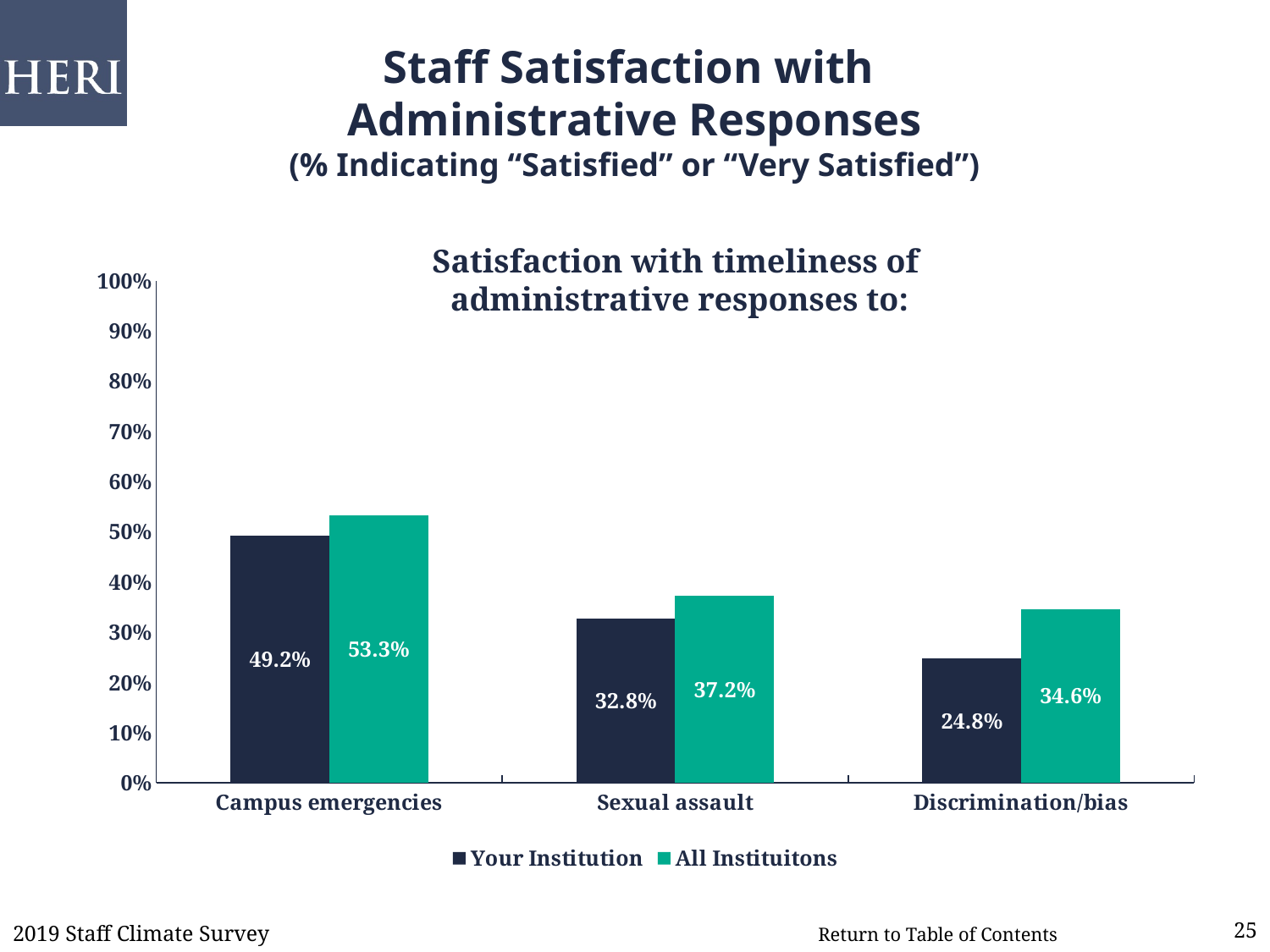
Is the value for Your Institution for Campus emergencies greater or less than 40%? greater Which is larger for Sexual assault: Your Institution or All Instituitons? All Instituitons Which category has the highest value for All Instituitons? Campus emergencies Which category has the lowest value for Your Institution? Discrimination/bias What is the value for Your Institution for Campus emergencies? 49.2% How many series does the legend list? 2 What is the title of the chart? Satisfaction with timeliness of administrative responses to: How many categories are shown on the x axis? 3 What kind of chart is shown on the slide? bar chart What is the value for Your Institution for Sexual assault? 32.8% What is the value for All Instituitons for Discrimination/bias? 34.6% What is the difference between All Instituitons and Your Institution for Discrimination/bias? 9.8%